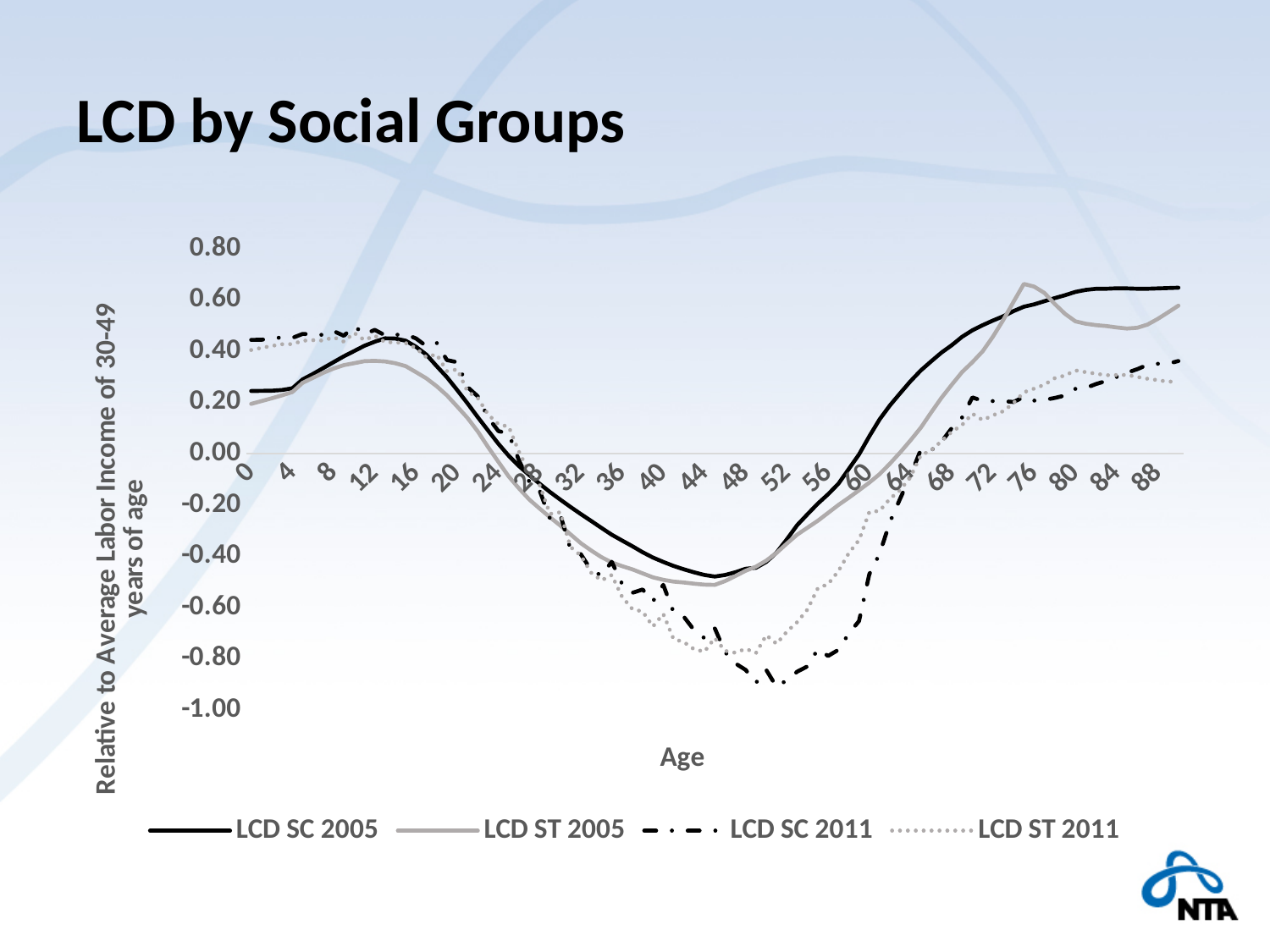
How many series does the legend list? 4 What kind of chart is shown on the slide? line chart Is the value for LCD SC 2011 at age 48 greater or less than -0.80? less At age 84, which series has the higher value, LCD SC 2005 or LCD SC 2011? LCD SC 2005 Is the value for LCD SC 2005 at age 88 greater or less than 0.40? greater At age 48, which series has the higher value, LCD SC 2005 or LCD SC 2011? LCD SC 2005 Is the value for LCD ST 2005 at age 12 greater or less than 0.20? greater What is the label of the x axis? Age Between age 60 and age 76, does the LCD ST 2005 line rise or fall? rise Between age 16 and age 44, does the LCD SC 2005 line rise or fall? fall What is the title of the chart? LCD by Social Groups